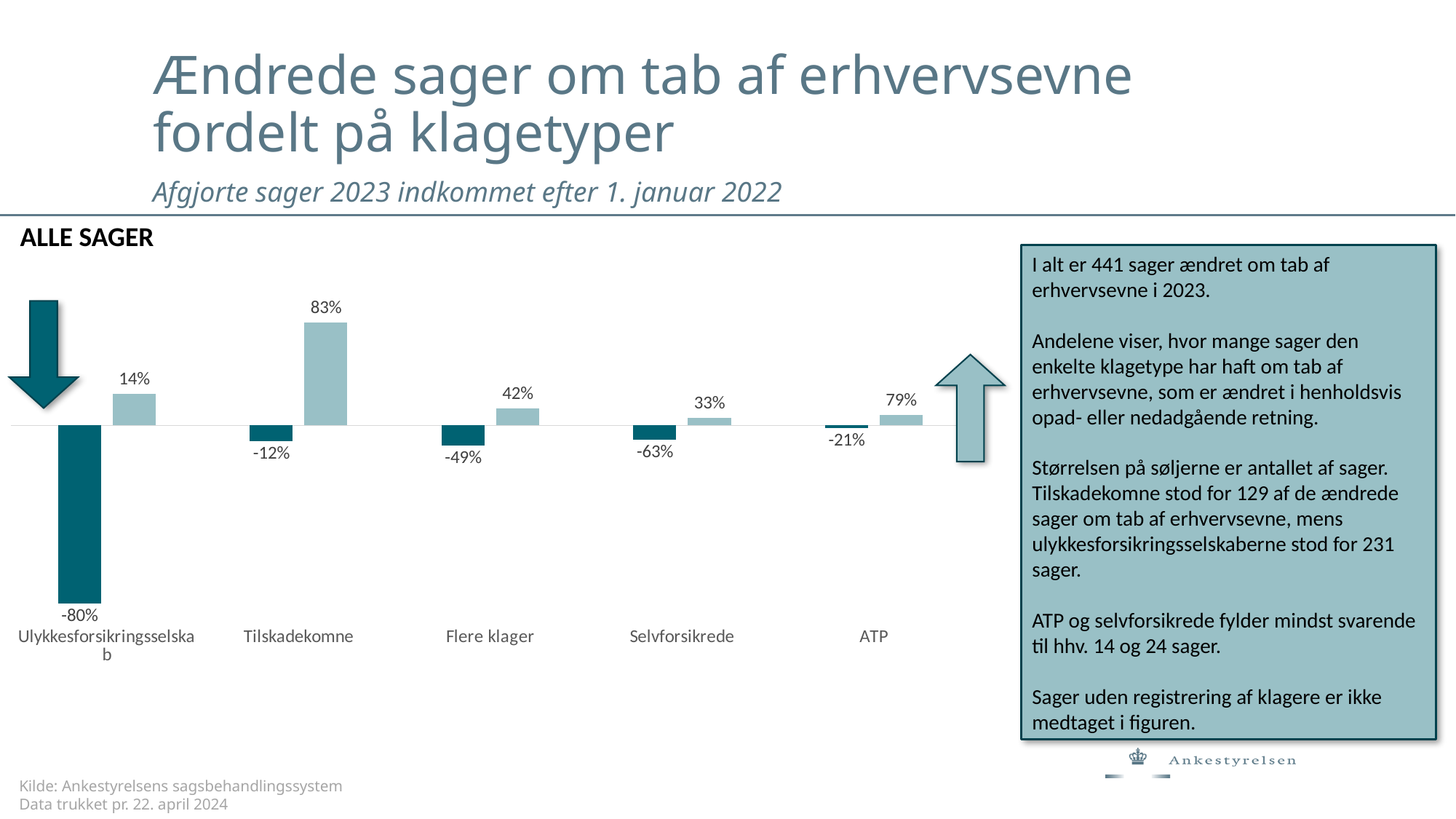
Which category has the lowest positive percentage label? Ulykkesforsikringsselskab What is the positive percentage shown for Flere klager? 42% How many categories are shown on the x axis of the chart? 5 What is the negative percentage shown for Selvforsikrede? -63% Which is larger, the positive percentage for Flere klager or the positive percentage for Selvforsikrede? Flere klager Which category has the highest positive percentage label? Tilskadekomne What is the difference between the positive percentage for Tilskadekomne and the positive percentage for ATP? 4 percentage points What is the upward (positive) percentage shown for Tilskadekomne? 83% What is the downward (negative) percentage shown for Tilskadekomne? -12% What is the negative percentage shown for Ulykkesforsikringsselskab? -80% What is the positive percentage shown for ATP? 79% What kind of chart is shown on the slide? Bar chart